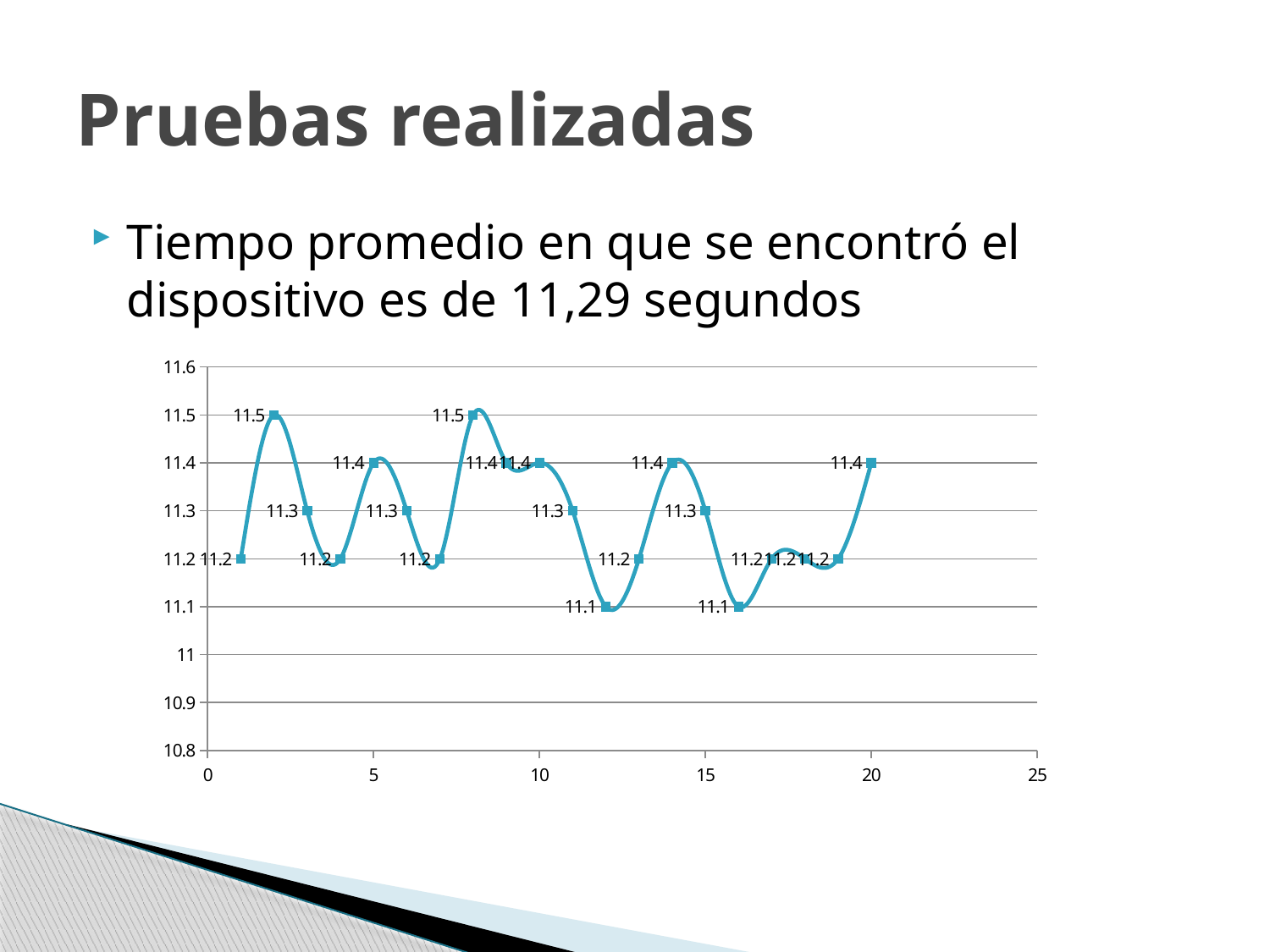
What is the lowest value plotted on the chart? 11.1 What is the value of the data point at x = 2? 11.5 What is the value of the data point at x = 12? 11.1 How many data points are plotted on the chart? 20 What is the highest value plotted on the chart? 11.5 What kind of chart is shown on the slide? line chart What is the minimum value shown on the vertical axis? 10.8 What is the value of the data point at x = 20? 11.4 What is the maximum value shown on the vertical axis? 11.6 Which is larger, the value at x = 5 or the value at x = 7? x = 5 Is the value at x = 16 greater or less than 11.2? less What is the difference between the value at x = 2 and the value at x = 12? 0.4